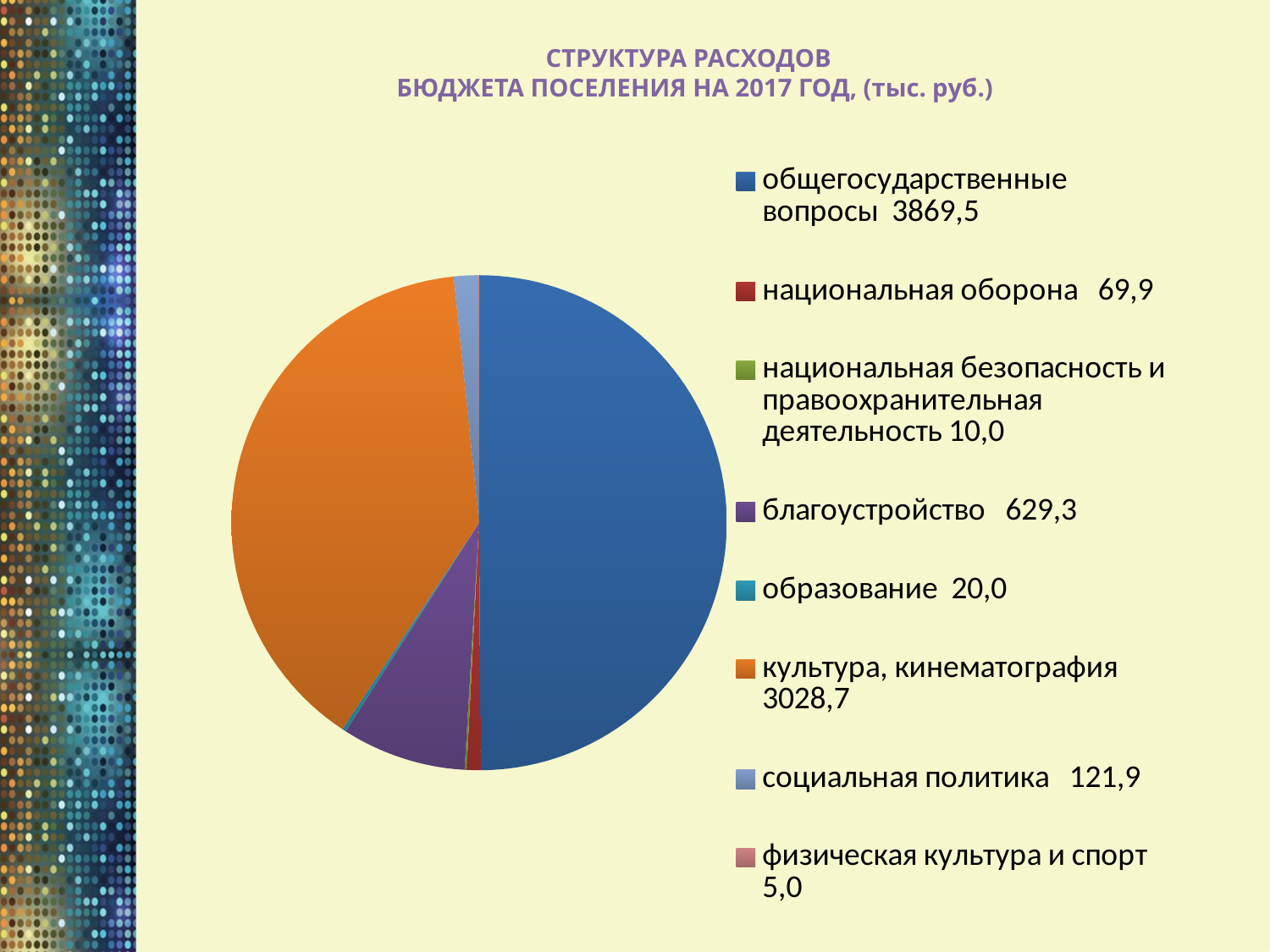
How many categories does the pie chart show? 8 Which category has the smallest value? физическая культура и спорт What is the value for общегосударственные вопросы? 3869,5 What is the value for культура, кинематография? 3028,7 Which is larger, национальная оборона or образование? национальная оборона What is the value for социальная политика? 121,9 Which category has the largest value? общегосударственные вопросы What is the value for благоустройство? 629,3 What is the difference between благоустройство and социальная политика? 507,4 What type of chart is shown on the slide? pie chart What is the difference between общегосударственные вопросы and культура, кинематография? 840,8 What is the title of the chart? СТРУКТУРА РАСХОДОВ БЮДЖЕТА ПОСЕЛЕНИЯ НА 2017 ГОД, (тыс. руб.)